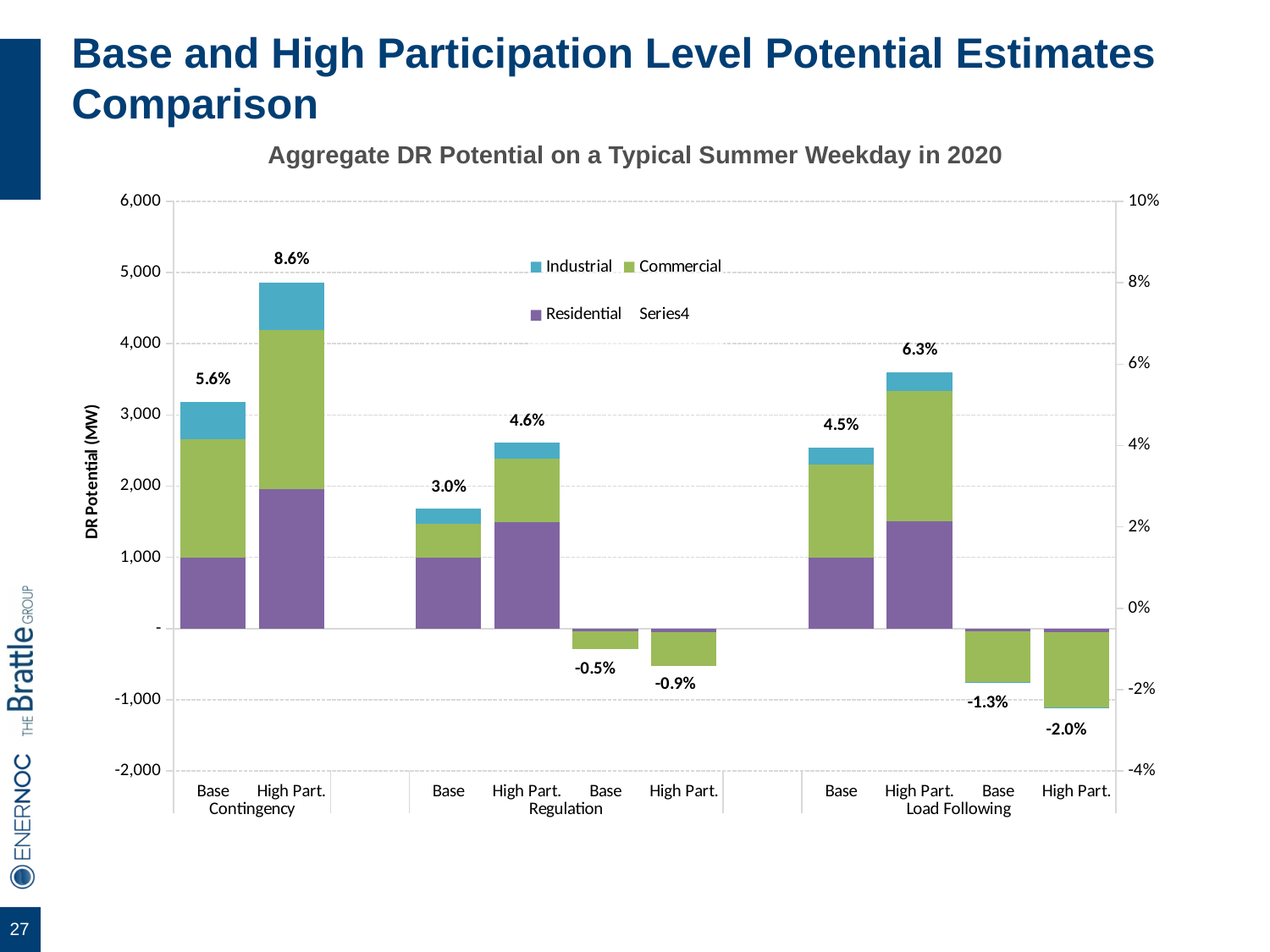
Which has a larger percentage label: the Regulation High Part. positive bar or the Load Following Base positive bar? Regulation High Part. (4.6%) What is the chart's title? Aggregate DR Potential on a Typical Summer Weekday in 2020 Is the total DR Potential (MW) of the Contingency High Part. bar greater or less than 4,000? greater What is the difference in percentage points between the Contingency High Part. label (8.6%) and the Contingency Base label (5.6%)? 3.0 percentage points What percentage label is shown for the Regulation Base bar with positive values? 3.0% What percentage label is shown for the Contingency High Part. bar? 8.6% What type of chart is shown on the slide? stacked bar chart What percentage label is shown for the Load Following High Part. bar with positive values? 6.3% Which bar has the lowest percentage label? Load Following High Part. (-2.0%) What percentage label is shown for the Contingency Base bar? 5.6% Which bar has the highest percentage label? Contingency High Part. (8.6%) How many series does the legend list? 4